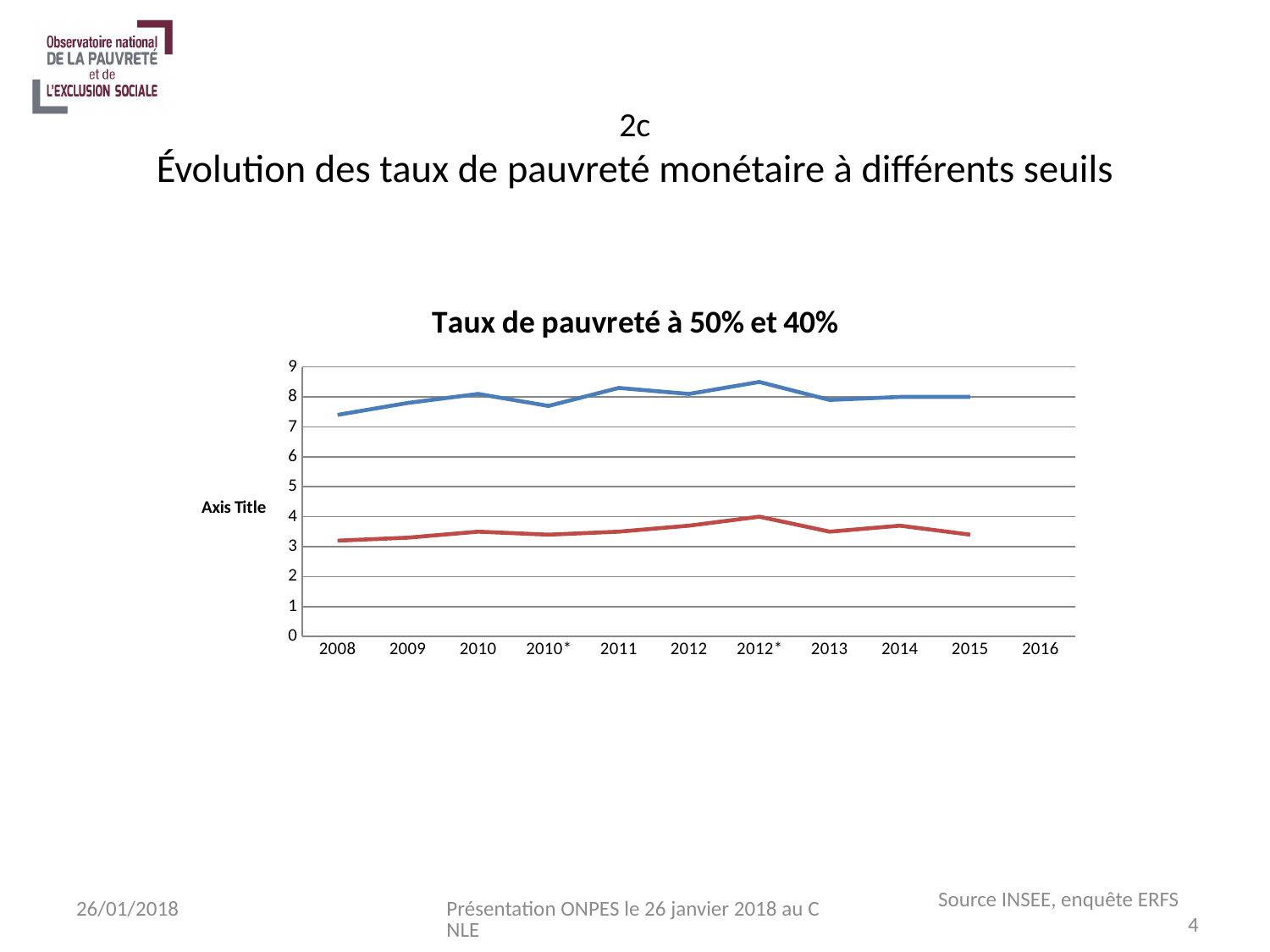
What kind of chart is shown on the slide? line chart Is the value of the red line for 2010 greater or less than 4? less Is the value of the blue line for 2008 greater or less than 8? less Is the value of the blue line for 2012* greater or less than 8? greater Does the blue line rise or fall between 2008 and 2010? rise What is the title of the chart? Taux de pauvreté à 50% et 40% How many lines are plotted on the chart? 2 In which year does the blue line reach its highest value? 2012* In which year does the blue line have its lowest value? 2008 In which year does the red line reach its highest value? 2012* How many year labels are shown on the x axis? 11